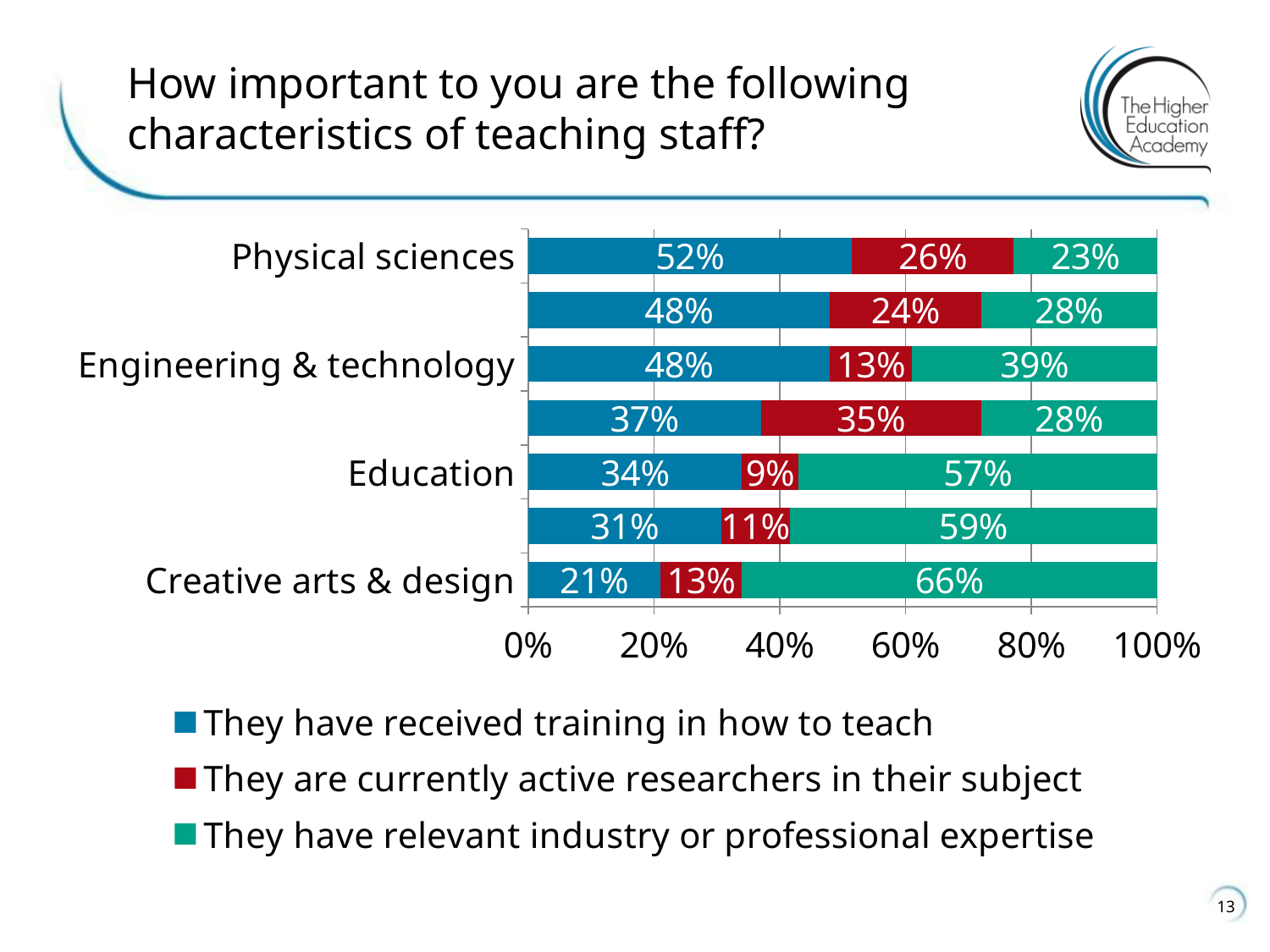
What is the value for 'They have relevant industry or professional expertise' for Education? 57% What is the difference between the 'They have received training in how to teach' values for Physical sciences and Creative arts & design? 31% What is the value for 'They are currently active researchers in their subject' for Engineering & technology? 13% Which legend entry is shown in red? They are currently active researchers in their subject How many bars (categories) are plotted in the chart? 7 How many series does the legend list? 3 What is the value for 'They have received training in how to teach' for Physical sciences? 52% What is the value for 'They have received training in how to teach' for Creative arts & design? 21% Which is larger: the 'They have relevant industry or professional expertise' value for Physical sciences or for Engineering & technology? Engineering & technology What kind of chart is shown on the slide? stacked bar chart Among the labelled categories, which has the lowest value for 'They are currently active researchers in their subject'? Education Among the labelled categories, which has the highest value for 'They have relevant industry or professional expertise'? Creative arts & design